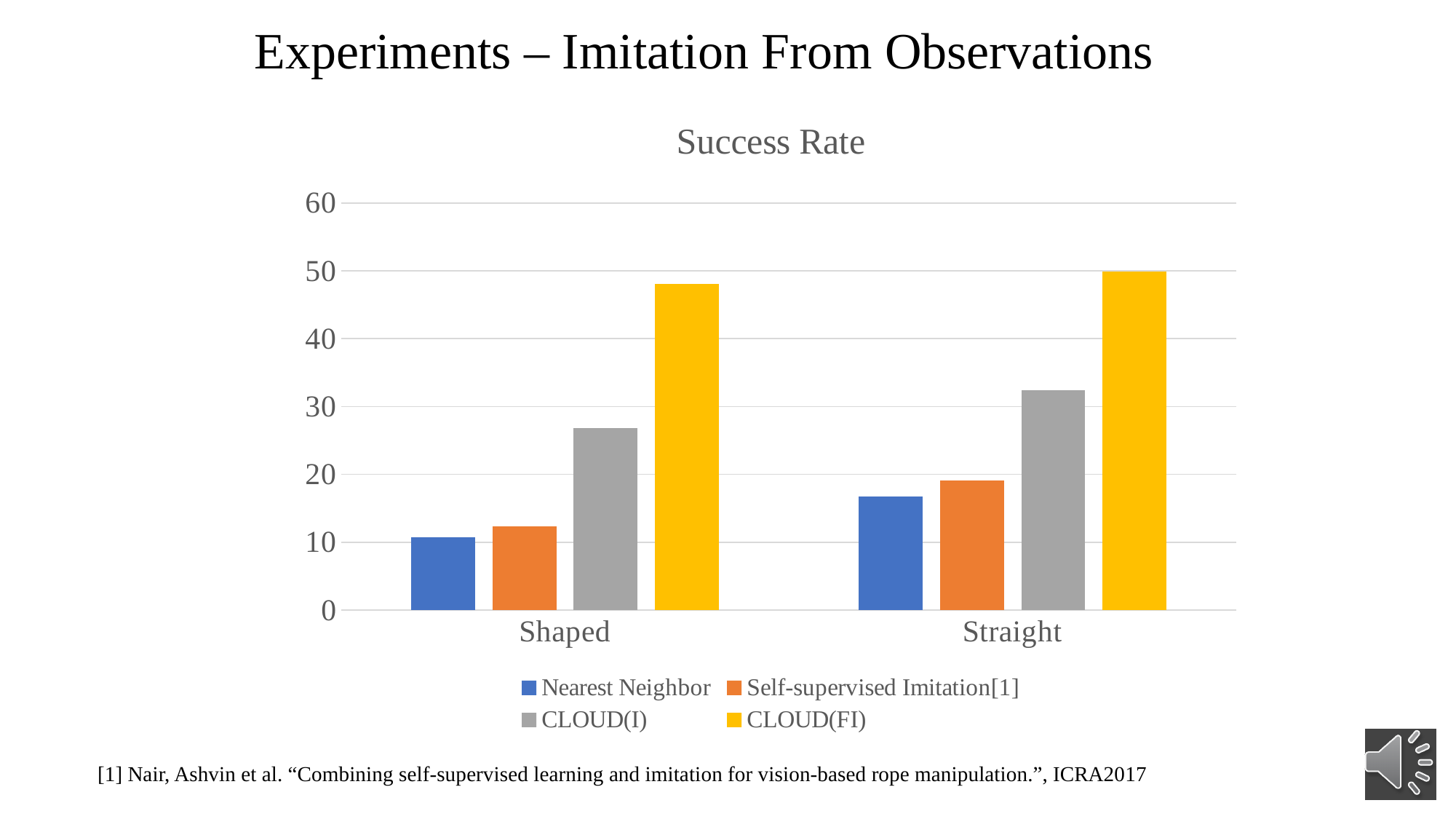
Which is larger: the CLOUD(I) value for Shaped or the CLOUD(I) value for Straight? Straight Is the value for CLOUD(I) in the Shaped category greater or less than 30? less What is the title of the chart? Success Rate Is the value for CLOUD(FI) in the Shaped category greater or less than 40? greater What type of chart is shown on the slide? bar chart How many categories are shown on the x axis? 2 How many series does the legend list? 4 Which series has the highest success rate for the Shaped category? CLOUD(FI) Is the value for Nearest Neighbor in the Straight category greater or less than 20? less Which series has the lowest success rate for the Straight category? Nearest Neighbor Which series has the lowest success rate for the Shaped category? Nearest Neighbor